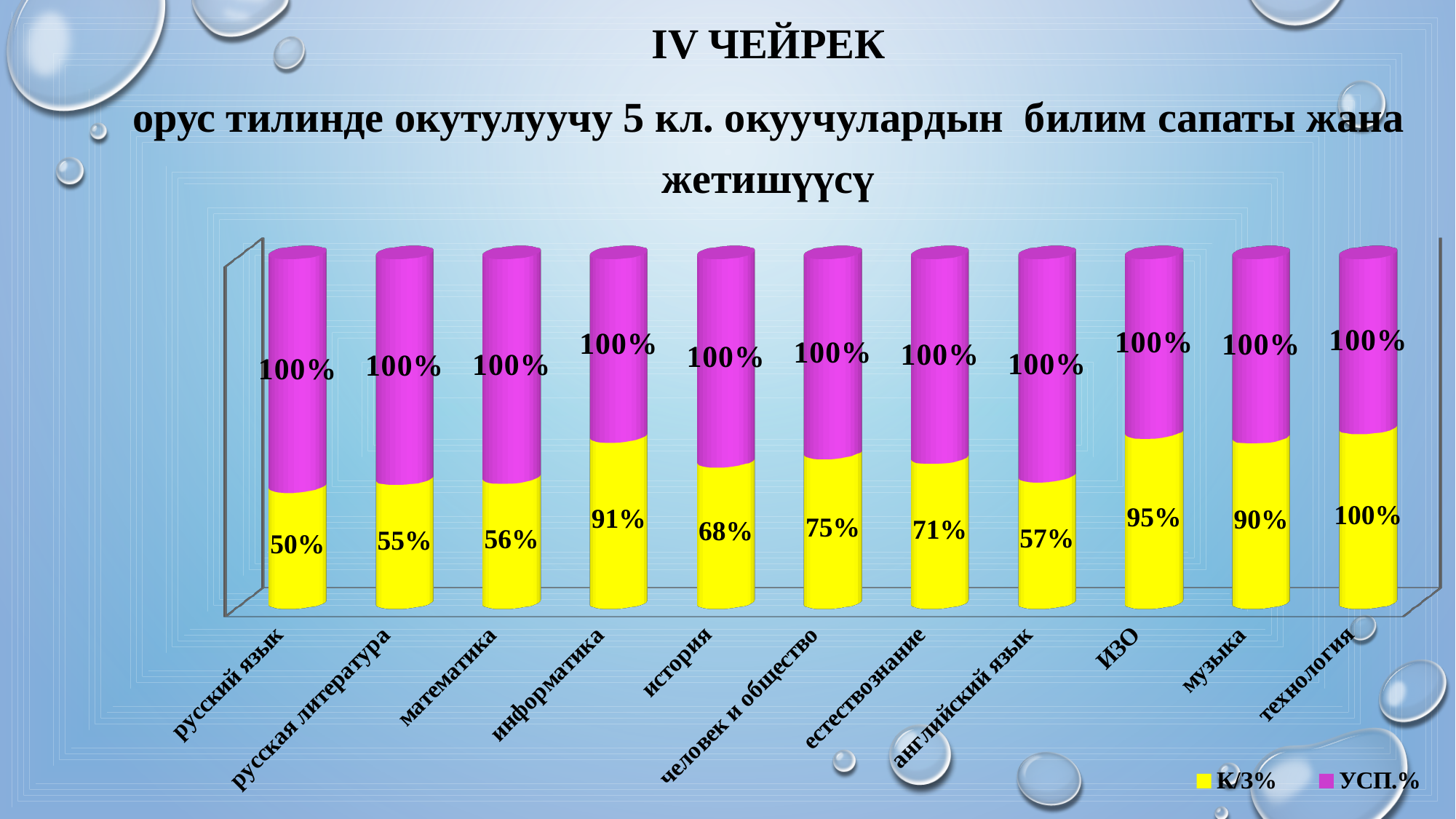
Which has a higher К/З% value, математика or история? история What kind of chart is shown on the slide? stacked bar chart What is the К/З% value for информатика? 91% Which colour represents the УСП.% series? magenta What is the УСП.% value for история? 100% What is the difference between the К/З% values for ИЗО and музыка? 5% What is the difference between the К/З% values for человек и общество and естествознание? 4% Which subject has the lowest К/З% value? русский язык How many series does the legend list? 2 Which subject has the highest К/З% value? технология What is the К/З% value for английский язык? 57% How many subjects are shown on the x axis? 11